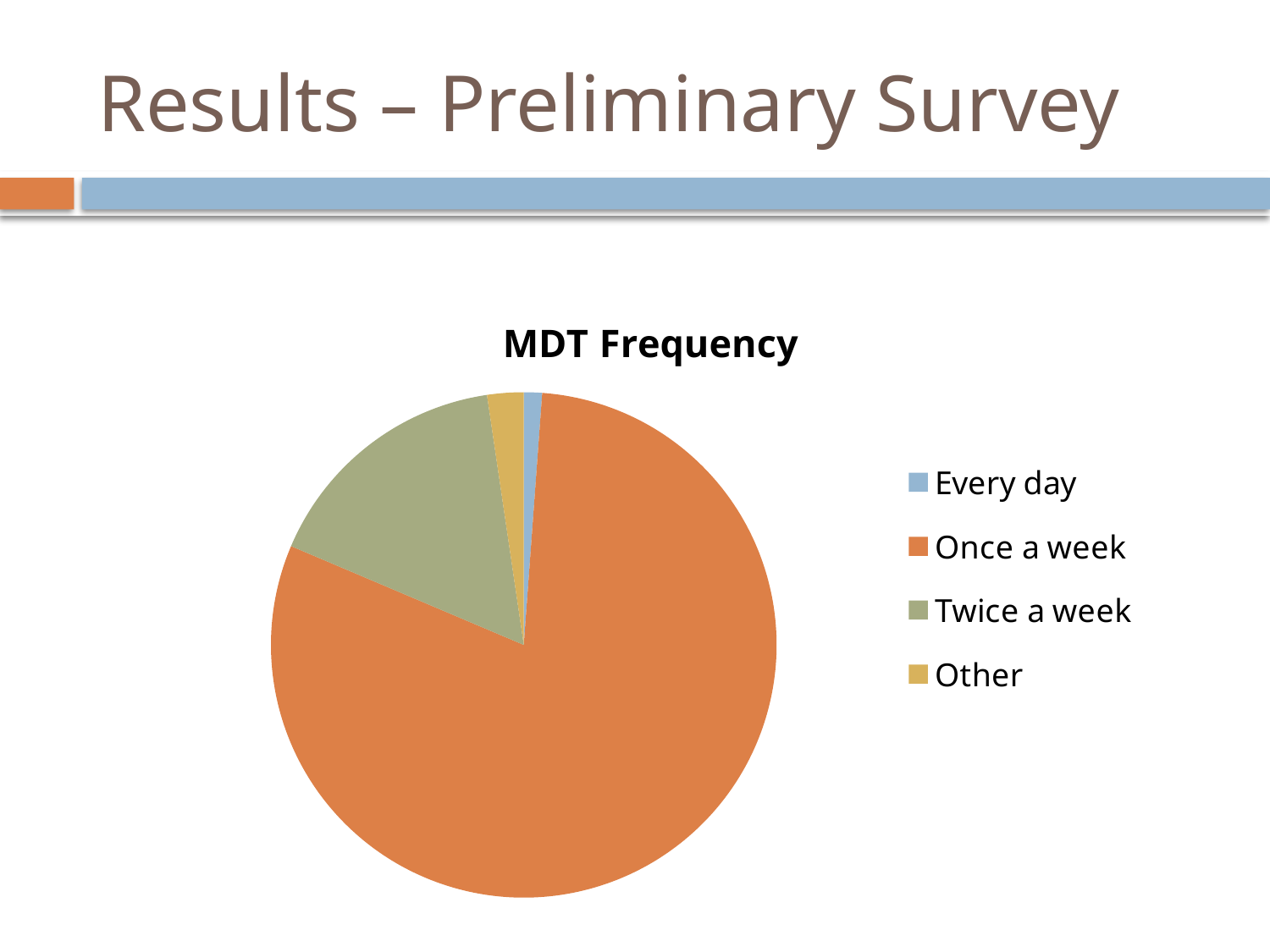
What colour is the Once a week slice in the pie chart? orange Does the Once a week slice take up more or less than half of the pie? more Which slice is larger, Once a week or Twice a week? Once a week What kind of chart is shown on the slide? pie chart Which slice is larger, Every day or Twice a week? Twice a week How many categories does the MDT Frequency pie chart have? 4 What is the title of the pie chart? MDT Frequency Which category has the largest slice in the MDT Frequency pie chart? Once a week